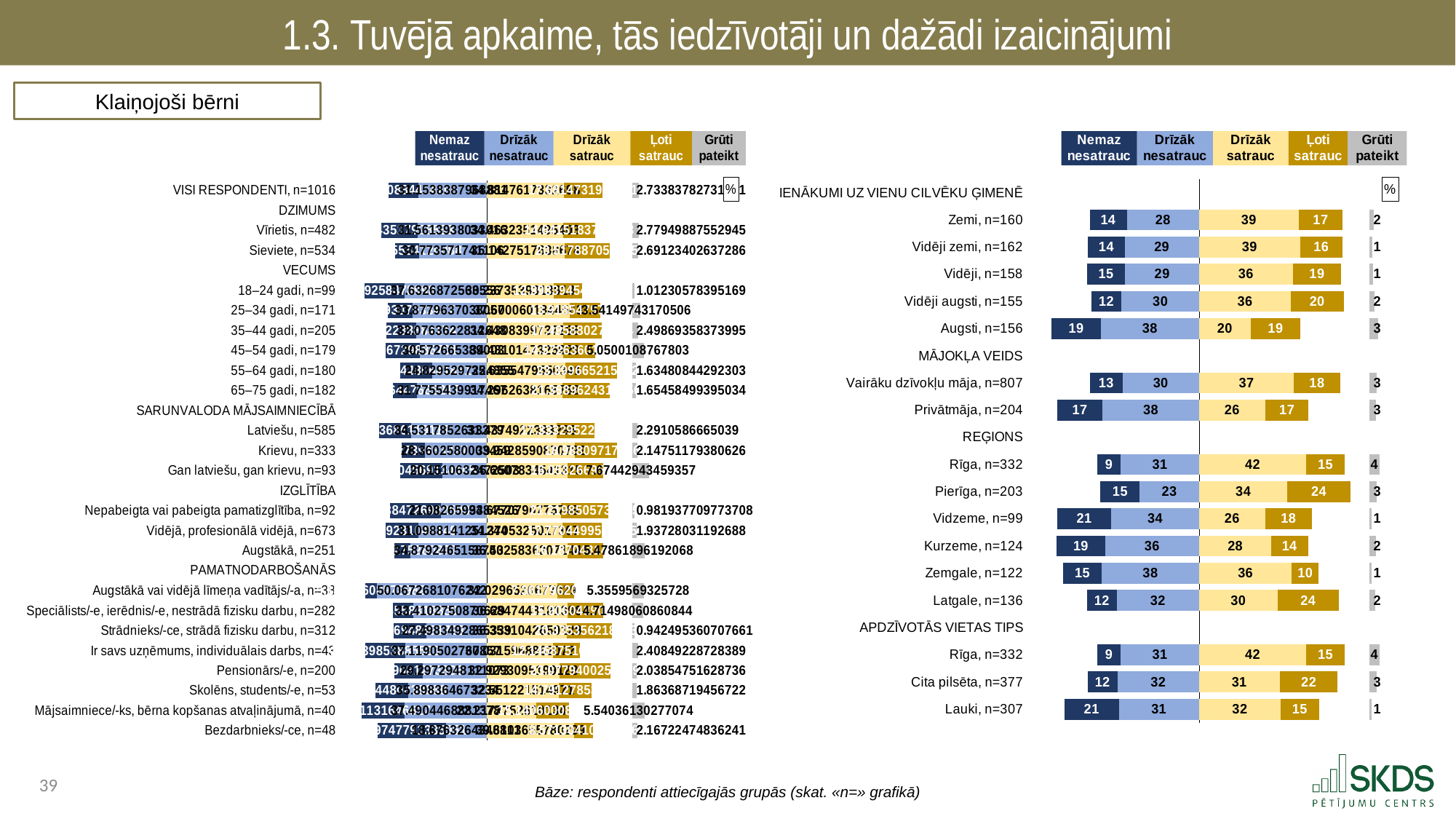
In the right-hand chart, which has the larger 'Nemaz nesatrauc' value: Lauki, n=307 or Cita pilsēta, n=377? Lauki, n=307 How many regions are listed under REĢIONS in the right-hand chart? 6 How many series does the legend of the right-hand chart list? 5 In the right-hand chart, what is the total of the stacked bar for Zemi, n=160? 100 What kind of chart is the left-hand chart? Stacked bar chart In the right-hand chart, what is the difference between the 'Drīzāk nesatrauc' values for Privātmāja, n=204 and Vairāku dzīvokļu māja, n=807? 8 In the right-hand chart, which region under REĢIONS has the lowest 'Ļoti satrauc' value? Zemgale, n=122 In the right-hand chart, which region under REĢIONS has the highest 'Drīzāk satrauc' value? Rīga, n=332 In the right-hand chart, what is the value of 'Nemaz nesatrauc' for Augsti, n=156? 19 In the right-hand chart, what is the value of 'Drīzāk satrauc' for Rīga, n=332 under REĢIONS? 42 In the right-hand chart, what is the value of 'Ļoti satrauc' for Latgale, n=136? 24 In the right-hand chart, what is the value of 'Grūti pateikt' for Vairāku dzīvokļu māja, n=807? 3